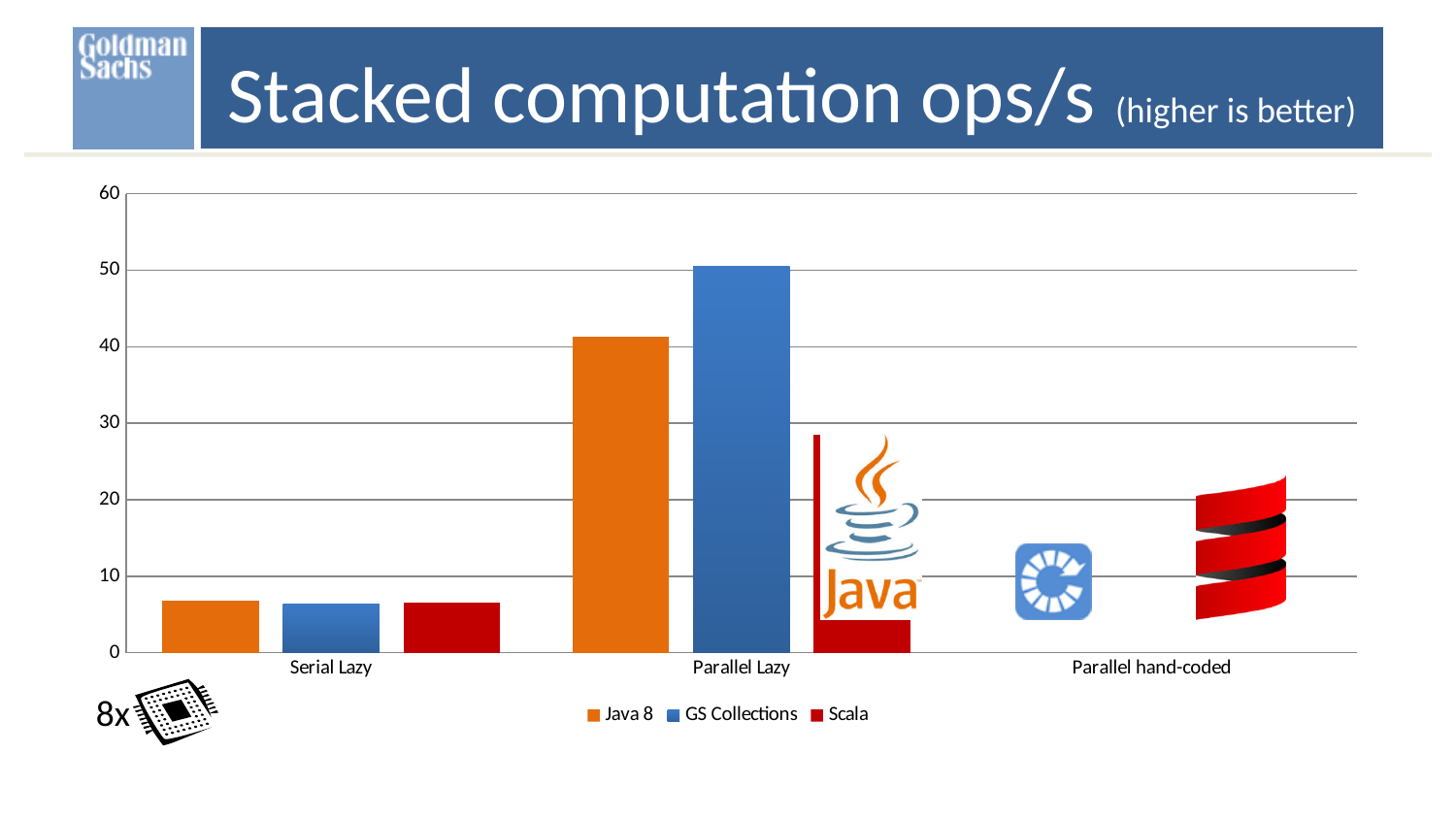
What kind of chart is shown on the slide? bar chart Which series has the highest value in the Parallel Lazy category? GS Collections Which is larger: Java 8 in Parallel Lazy or Java 8 in Serial Lazy? Java 8 in Parallel Lazy How many series does the legend list? 3 Which series is shown in orange in the legend? Java 8 What is the title of the chart? Stacked computation ops/s (higher is better) How many categories are shown on the x axis? 3 Is the value for Scala in the Serial Lazy category greater or less than 10? less Is the value for Java 8 in the Parallel Lazy category greater or less than 40? greater Which is larger: GS Collections in Parallel Lazy or Java 8 in Parallel Lazy? GS Collections in Parallel Lazy Is the value for Java 8 in the Serial Lazy category greater or less than 10? less